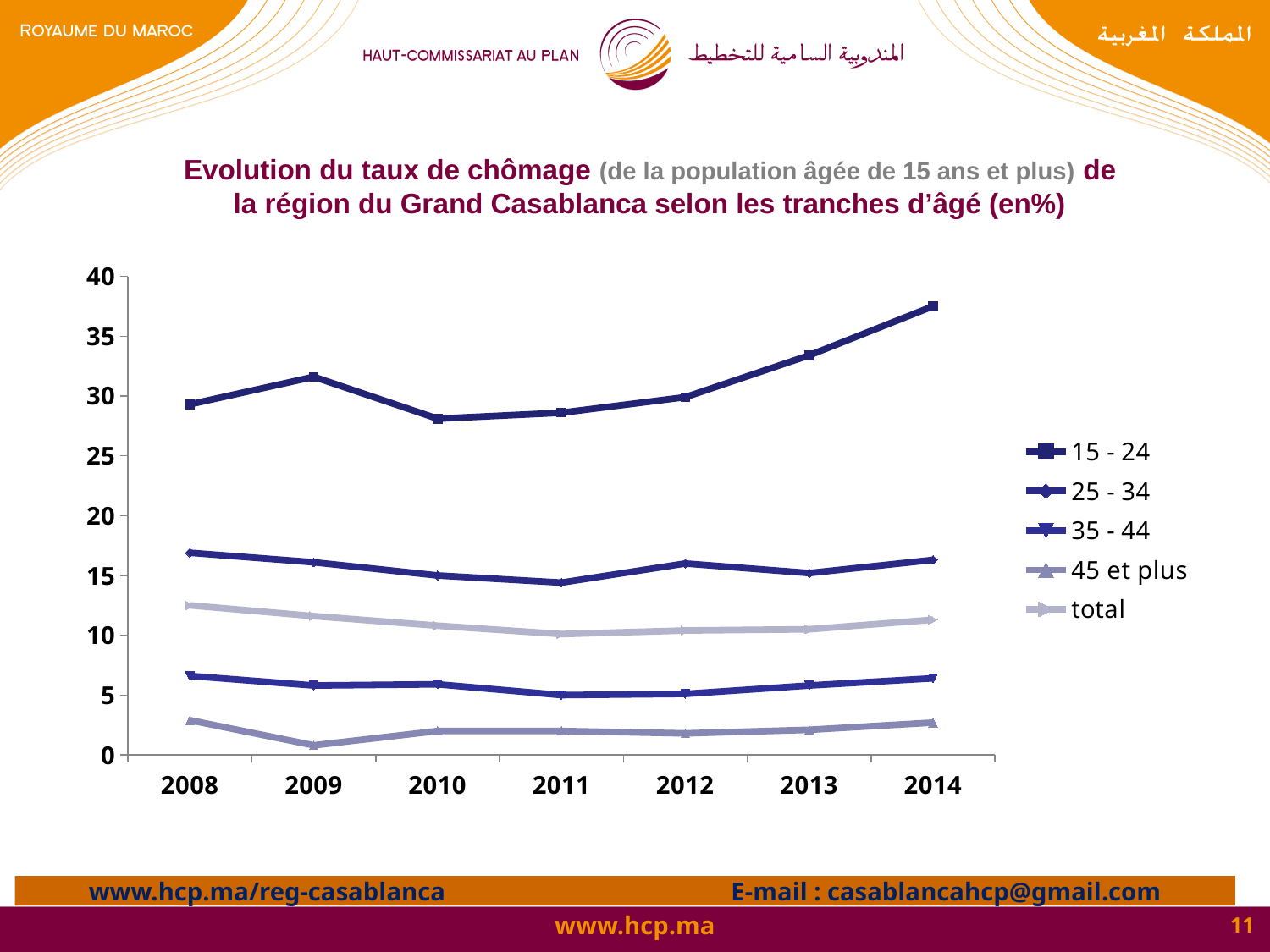
Is the value for 35 - 44 in 2008 greater or less than 5? greater Which series has the highest values across all years? 15 - 24 How many years are shown on the x axis? 7 In which year is the unemployment rate for the 45 et plus group lowest? 2009 In 2008, which is larger: the value for 25 - 34 or the value for total? 25 - 34 In which year is the unemployment rate for the 15 - 24 group highest? 2014 What are the entries listed in the legend? 15 - 24, 25 - 34, 35 - 44, 45 et plus, total Is the value for 15 - 24 in 2010 greater or less than 30? less Does the 15 - 24 line rise or fall from 2012 to 2014? rise Is the value for 15 - 24 in 2014 greater or less than 35? greater How many series does the legend list? 5 What kind of chart is shown on the slide? line chart